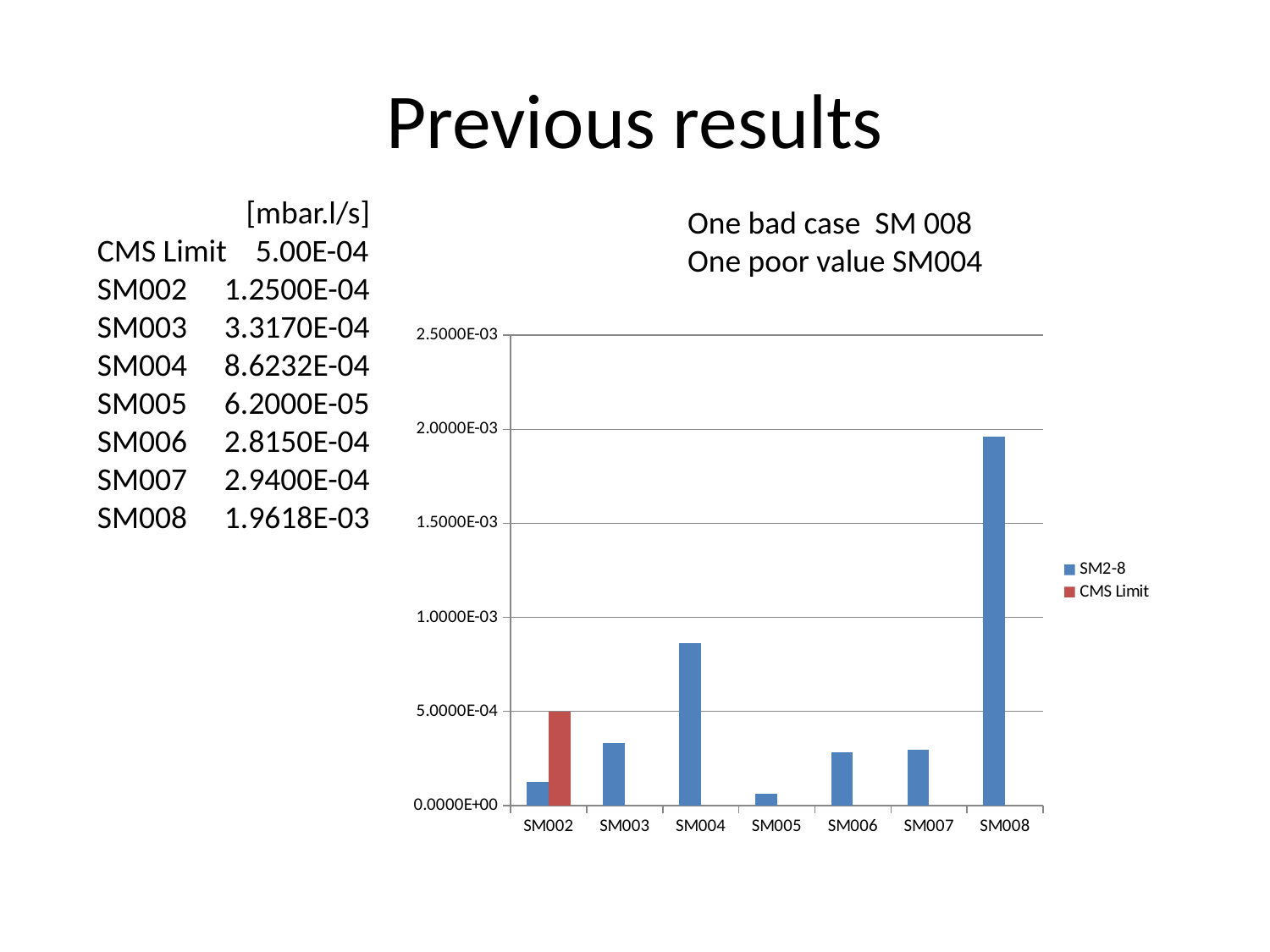
Which is larger, the value for SM004 or the value for SM006? SM004 What kind of chart is shown on the slide? bar chart Is the value for SM003 greater or less than 5.0000E-04? less Which category has the lowest SM2-8 value in the chart? SM005 What colour is the CMS Limit bar in the chart? red What is the value for SM008 in mbar.l/s? 1.9618E-03 What is the value for SM004 in mbar.l/s? 8.6232E-04 Is the value for SM008 greater or less than 1.5000E-03? greater How many categories are shown on the x axis of the chart? 7 What is the CMS Limit value shown on the slide? 5.00E-04 Which category has the highest SM2-8 value in the chart? SM008 How many series does the chart legend list? 2